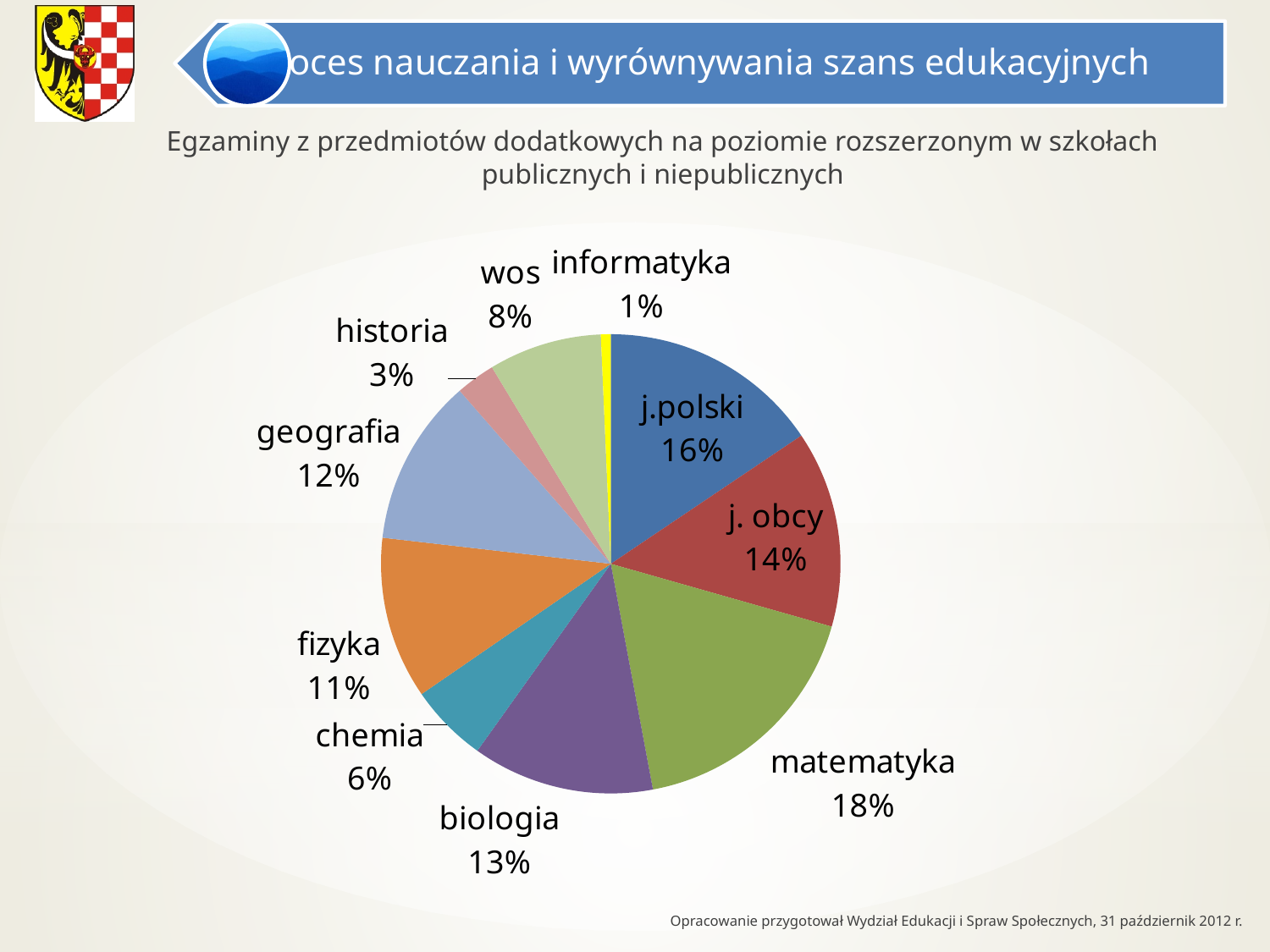
What is the difference in percentage points between wos and historia? 5 What percentage is shown for geografia? 12% Which subject has the smallest slice of the pie? informatyka What kind of chart is shown on the slide? pie chart What is the difference in percentage points between matematyka and biologia? 5 What is the value for chemia? 6% What share of the pie does matematyka have? 18% Which subject has the largest slice of the pie? matematyka How many slices does the pie chart have? 10 Which is larger, the share for j. obcy or the share for fizyka? j. obcy What is the value shown for j.polski? 16% What is the title text above the pie chart? Egzaminy z przedmiotów dodatkowych na poziomie rozszerzonym w szkołach publicznych i niepublicznych